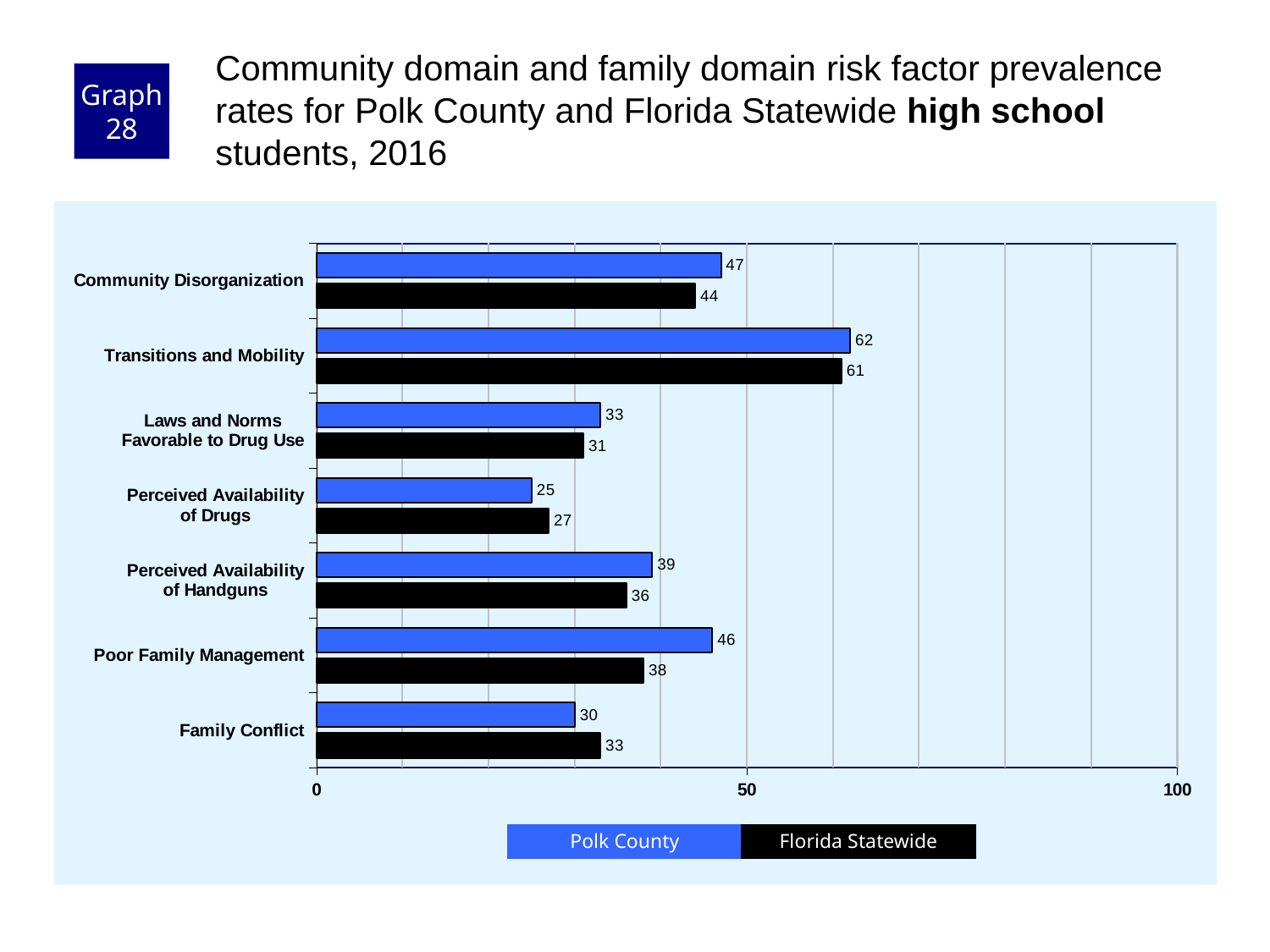
How many series does the legend list? 2 Which colour represents Florida Statewide in the chart? black Is the Florida Statewide value for Transitions and Mobility greater or less than 50? greater What is the Polk County value for Perceived Availability of Drugs? 25 What is the Polk County value for Transitions and Mobility? 62 Which risk factor has the highest Polk County value? Transitions and Mobility What kind of chart is shown on the slide? bar chart For Family Conflict, which is larger: the Polk County value or the Florida Statewide value? Florida Statewide What is the difference between the Polk County and Florida Statewide values for Poor Family Management? 8 Which risk factor has the lowest Florida Statewide value? Perceived Availability of Drugs How many risk factors are shown on the chart? 7 What is the Florida Statewide value for Poor Family Management? 38